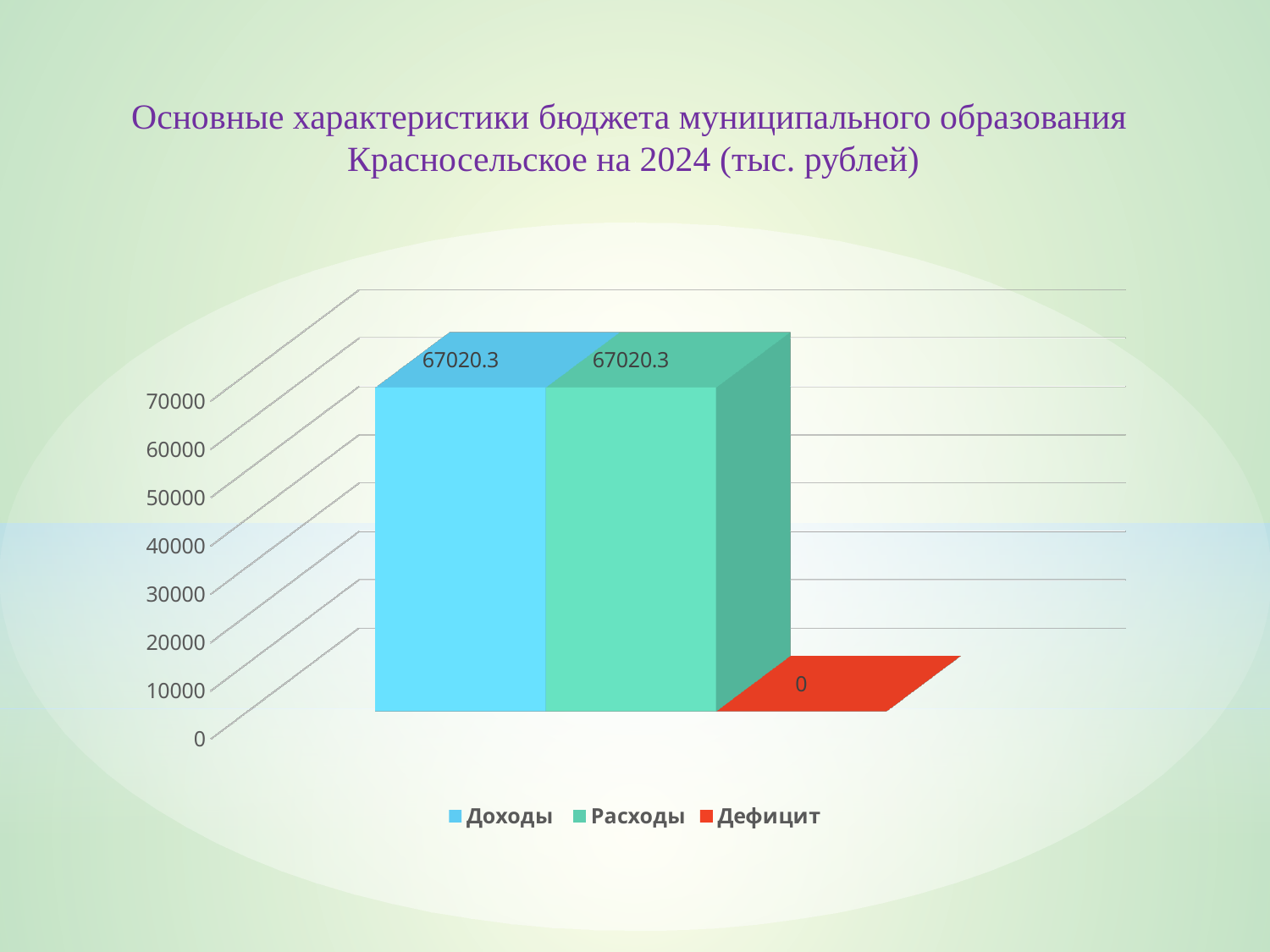
What is the difference between Расходы and Дефицит? 67020.3 What is the difference between Доходы and Расходы? 0 Which series has the lowest value? Дефицит What colour is the Дефицит series in the legend? red Which is larger, Доходы or Дефицит? Доходы Is the value for Доходы greater or less than 60000? greater What is the value for Расходы? 67020.3 Is the value for Дефицит greater or less than 10000? less How many series does the legend list? 3 What is the value for Дефицит? 0 What is the value for Доходы? 67020.3 What kind of chart is shown on the slide? bar chart